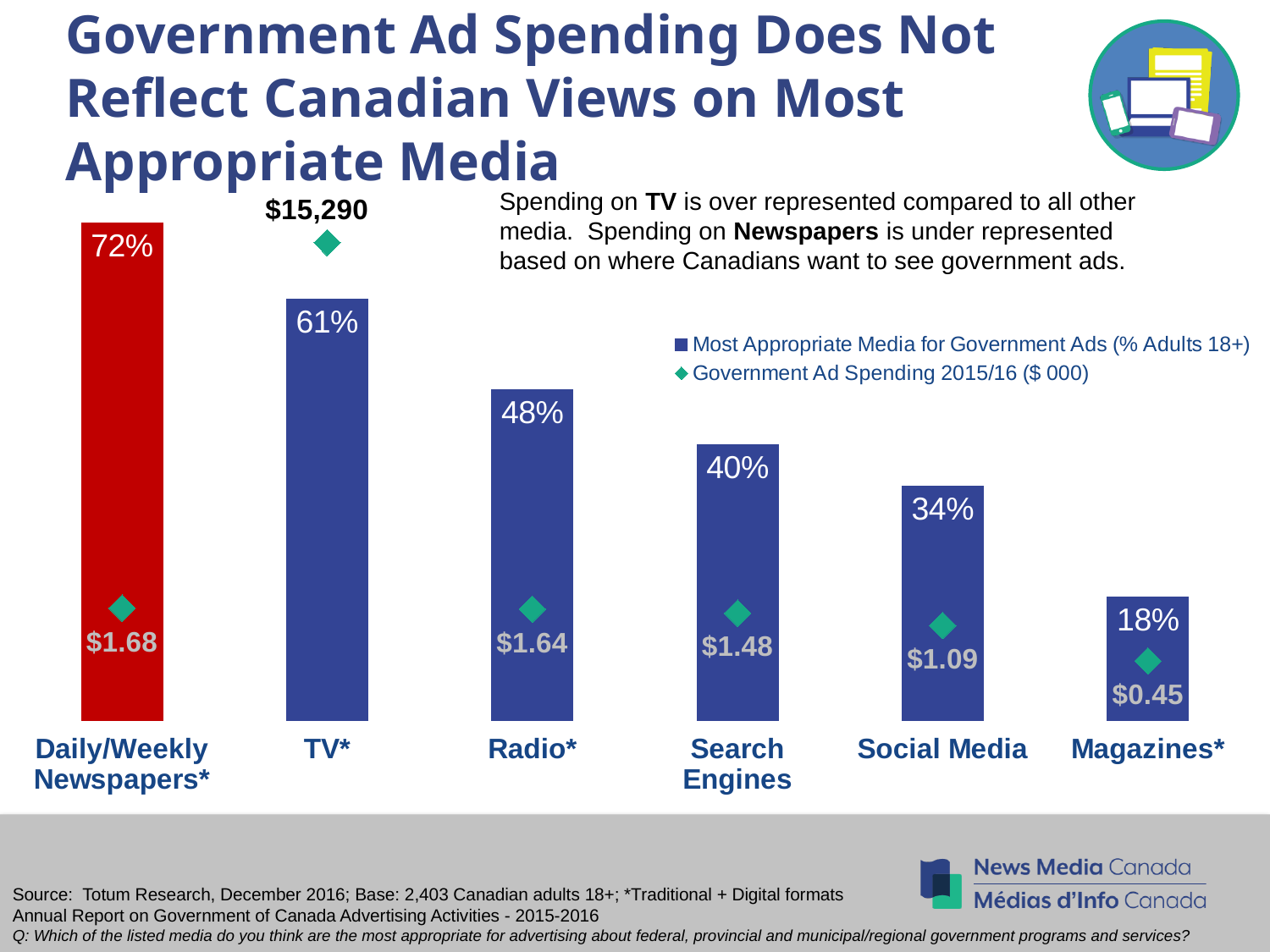
Which media category has the lowest Government Ad Spending 2015/16? Magazines* What was the Government Ad Spending 2015/16 ($ 000) for TV? $15,290 Do the Most Appropriate Media percentages rise or fall from left to right across the categories? Fall Which media category has the highest percentage for Most Appropriate Media for Government Ads? Daily/Weekly Newspapers* Which bar is coloured red rather than blue? Daily/Weekly Newspapers* What was the Government Ad Spending 2015/16 ($ 000) for Magazines? $0.45 How many media categories are shown on the chart? 6 How many series does the legend list? 2 What is the difference in percentage points between TV and Radio for Most Appropriate Media for Government Ads? 13 What kind of chart is used to show the Most Appropriate Media for Government Ads values? Bar chart What percentage of adults consider Daily/Weekly Newspapers the most appropriate media for government ads? 72% Which has a higher Most Appropriate Media percentage, Search Engines or Social Media? Search Engines